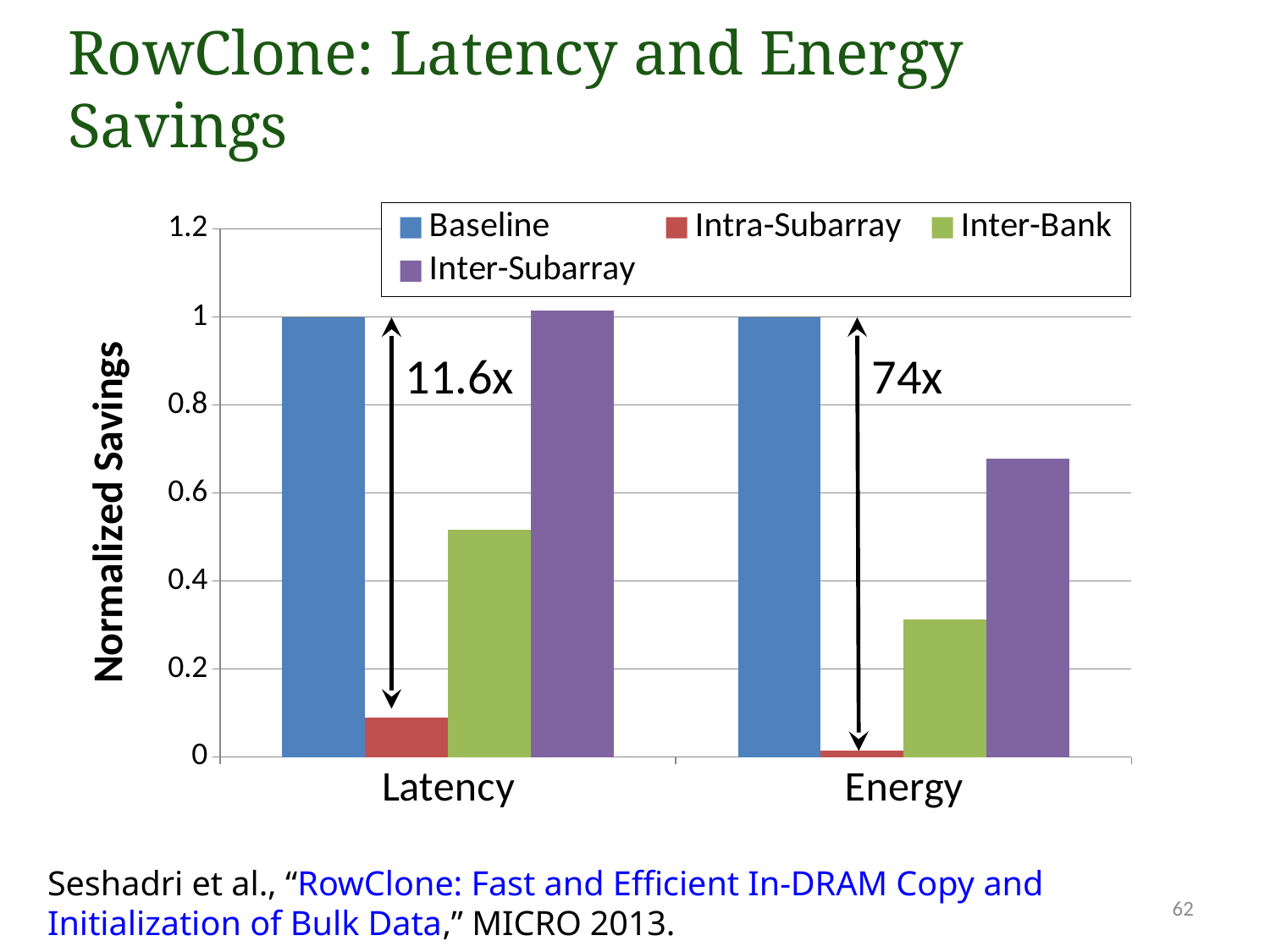
Is the Inter-Bank value for Latency greater or less than 0.4? greater What is the Baseline value for Energy? 1 How many categories are shown on the x axis? 2 Is the Inter-Bank value for Energy greater or less than 0.4? less What is the Baseline value for Latency? 1 Which is larger, the Inter-Bank value for Latency or the Inter-Bank value for Energy? Latency Is the Intra-Subarray value for Latency greater or less than 0.2? less How many series does the legend list? 4 Which series has the highest value for Energy? Baseline Which series has the lowest value for Energy? Intra-Subarray What kind of chart is shown on the slide? bar chart